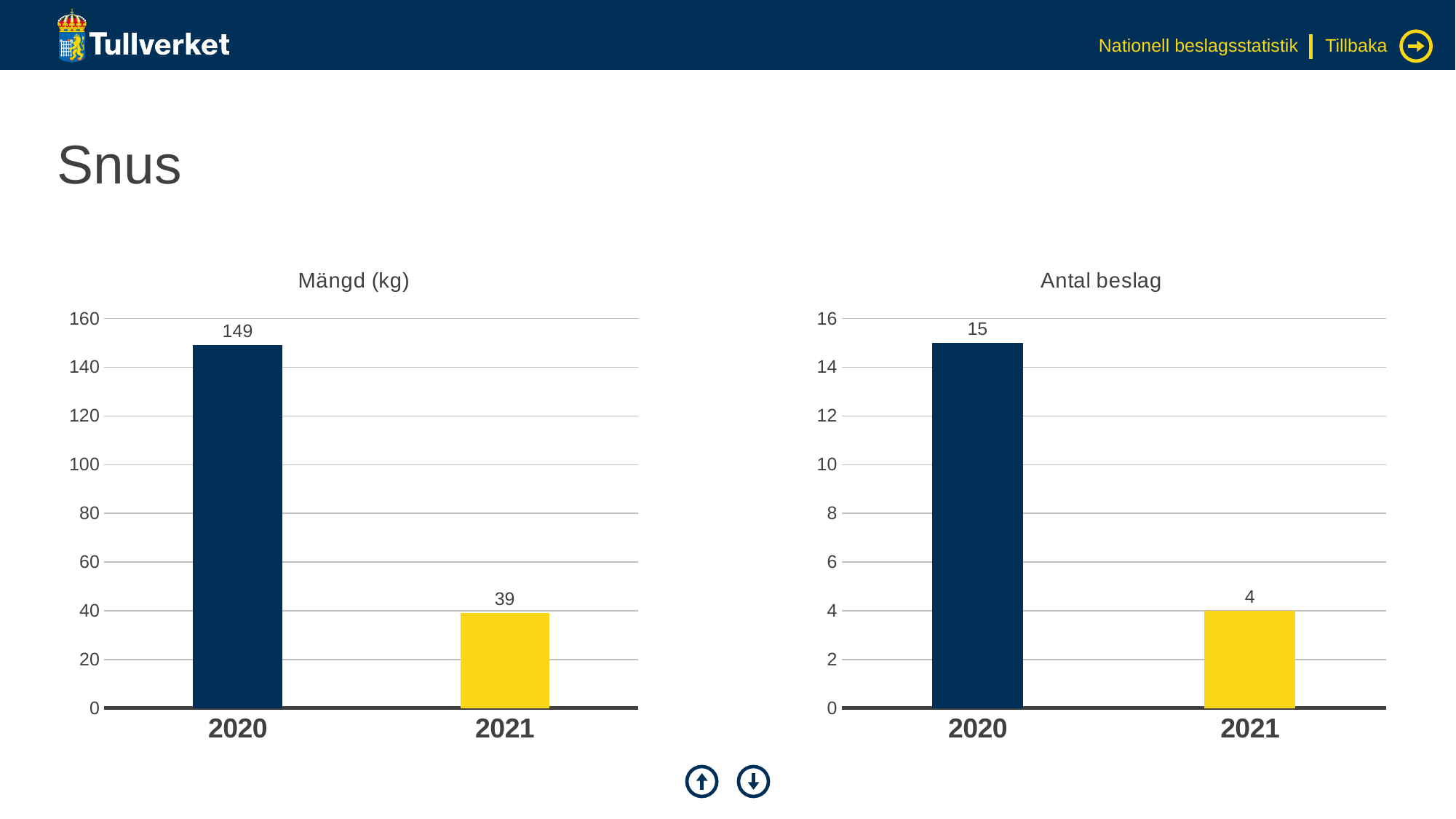
In the 'Mängd (kg)' chart, which year has the highest value? 2020 What kind of chart is the 'Antal beslag' chart? bar chart In the 'Mängd (kg)' chart, what is the value for 2021? 39 In the 'Antal beslag' chart, what is the difference between the 2020 and 2021 values? 11 In the 'Antal beslag' chart, what is the value for 2020? 15 How many years are shown on the x axis of the 'Mängd (kg)' chart? 2 In the 'Antal beslag' chart, is the value for 2020 greater or less than 10? greater In the 'Mängd (kg)' chart, what is the value for 2020? 149 In the 'Mängd (kg)' chart, do the values rise or fall from 2020 to 2021? fall In the 'Mängd (kg)' chart, what is the difference between the 2020 and 2021 values? 110 In the 'Antal beslag' chart, what is the value for 2021? 4 In the 'Antal beslag' chart, which year has the lowest value? 2021